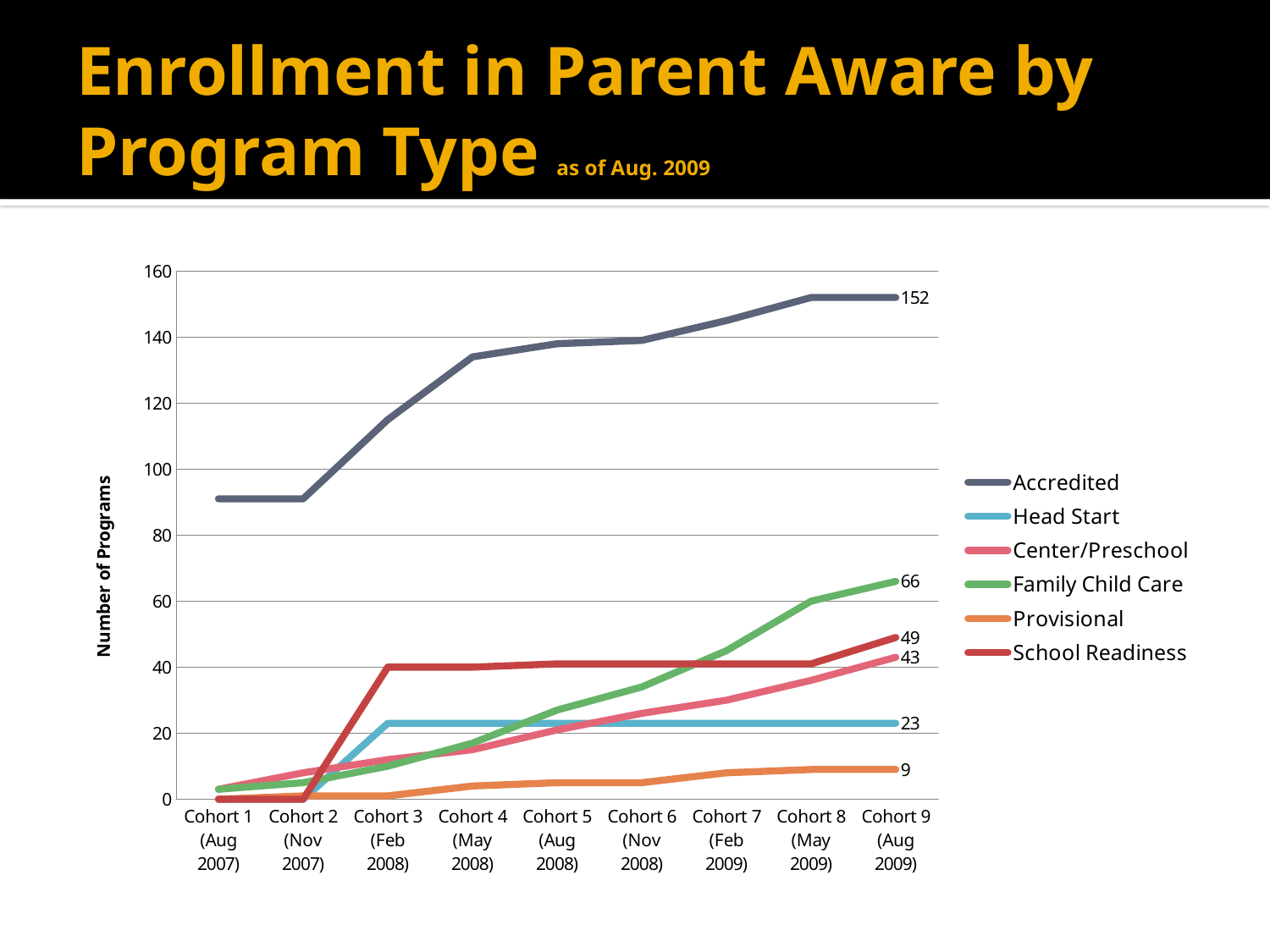
At Cohort 9 (Aug 2009), which is larger: Center/Preschool or Head Start? Center/Preschool What is the value for Family Child Care at Cohort 9 (Aug 2009)? 66 What kind of chart is shown on the slide? line chart How many cohorts are shown on the x axis? 9 What is the value for School Readiness at Cohort 9 (Aug 2009)? 49 Which program type has the highest number of programs at Cohort 9 (Aug 2009)? Accredited What is the value for Accredited at Cohort 9 (Aug 2009)? 152 What is the value for Provisional at Cohort 9 (Aug 2009)? 9 What is the difference between Accredited and Family Child Care at Cohort 9 (Aug 2009)? 86 Is the value for Accredited at Cohort 1 (Aug 2007) greater or less than 100? less How many series does the legend list? 6 Which program type has the lowest number of programs at Cohort 9 (Aug 2009)? Provisional